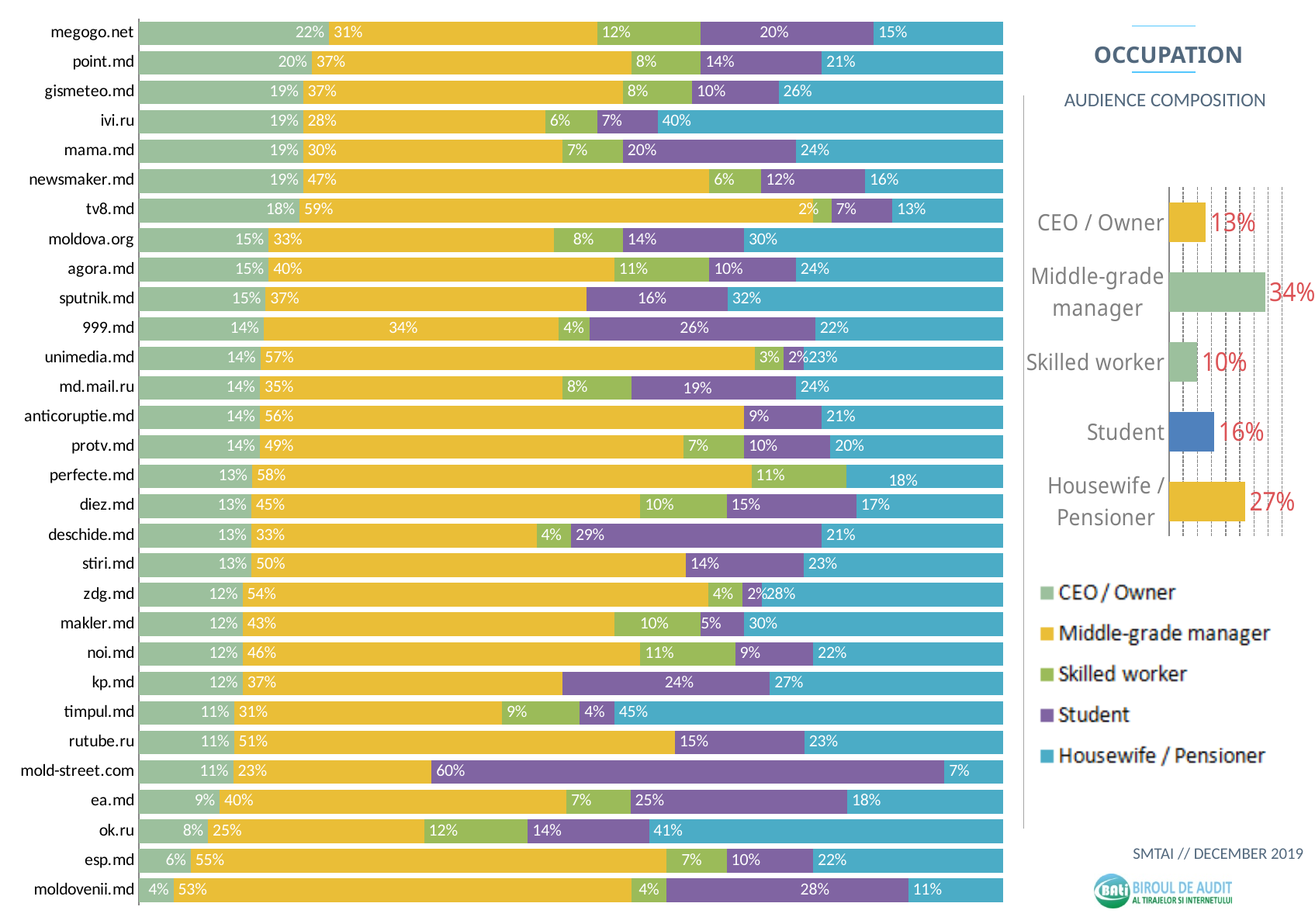
How many series does the legend of the large audience composition chart list? 5 In the right-hand 'Occupation' chart, what is the difference between Middle-grade manager and CEO / Owner? 21 percentage points What kind of chart is the large audience composition chart on the left? Stacked bar chart In the large audience composition chart on the left, which website has the highest CEO / Owner share? megogo.net In the right-hand 'Occupation' chart, which occupation has the lowest value? Skilled worker In the large audience composition chart on the left, for ok.ru, which is larger: the Student share or the Housewife / Pensioner share? Housewife / Pensioner In the large audience composition chart on the left, how many websites are listed? 30 In the right-hand 'Occupation' chart, what is the value for Student? 16% In the right-hand 'Occupation' chart, what is the value for Middle-grade manager? 34% In the large audience composition chart on the left, what is the Student share for mold-street.com? 60% In the large audience composition chart on the left, which website has the lowest CEO / Owner share? moldovenii.md In the large audience composition chart on the left, what is the Middle-grade manager share for tv8.md? 59%